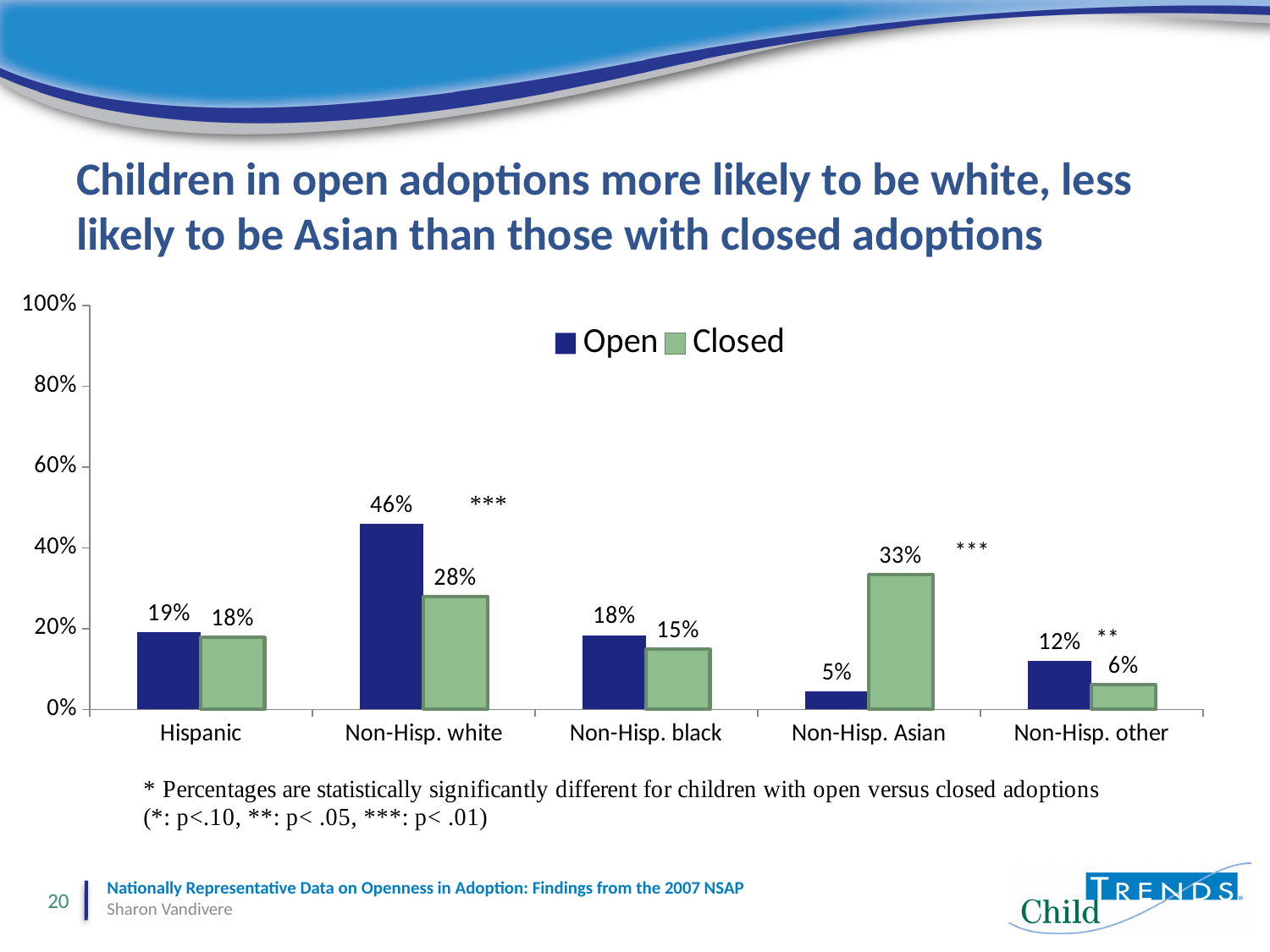
How many categories are shown on the x axis? 5 Which is larger for Non-Hisp. Asian, the Open value or the Closed value? Closed Which category has the lowest Closed value? Non-Hisp. other What is the Closed value for Hispanic? 18% What is the Open value for Non-Hisp. other? 12% How many series does the legend list? 2 What is the Closed value for Non-Hisp. Asian? 33% What is the Open value for Non-Hisp. white? 46% What kind of chart is shown on the slide? Bar chart Which category has the highest Open value? Non-Hisp. white What is the difference between the Open and Closed values for Non-Hisp. white? 18% Which category has the lowest Open value? Non-Hisp. Asian